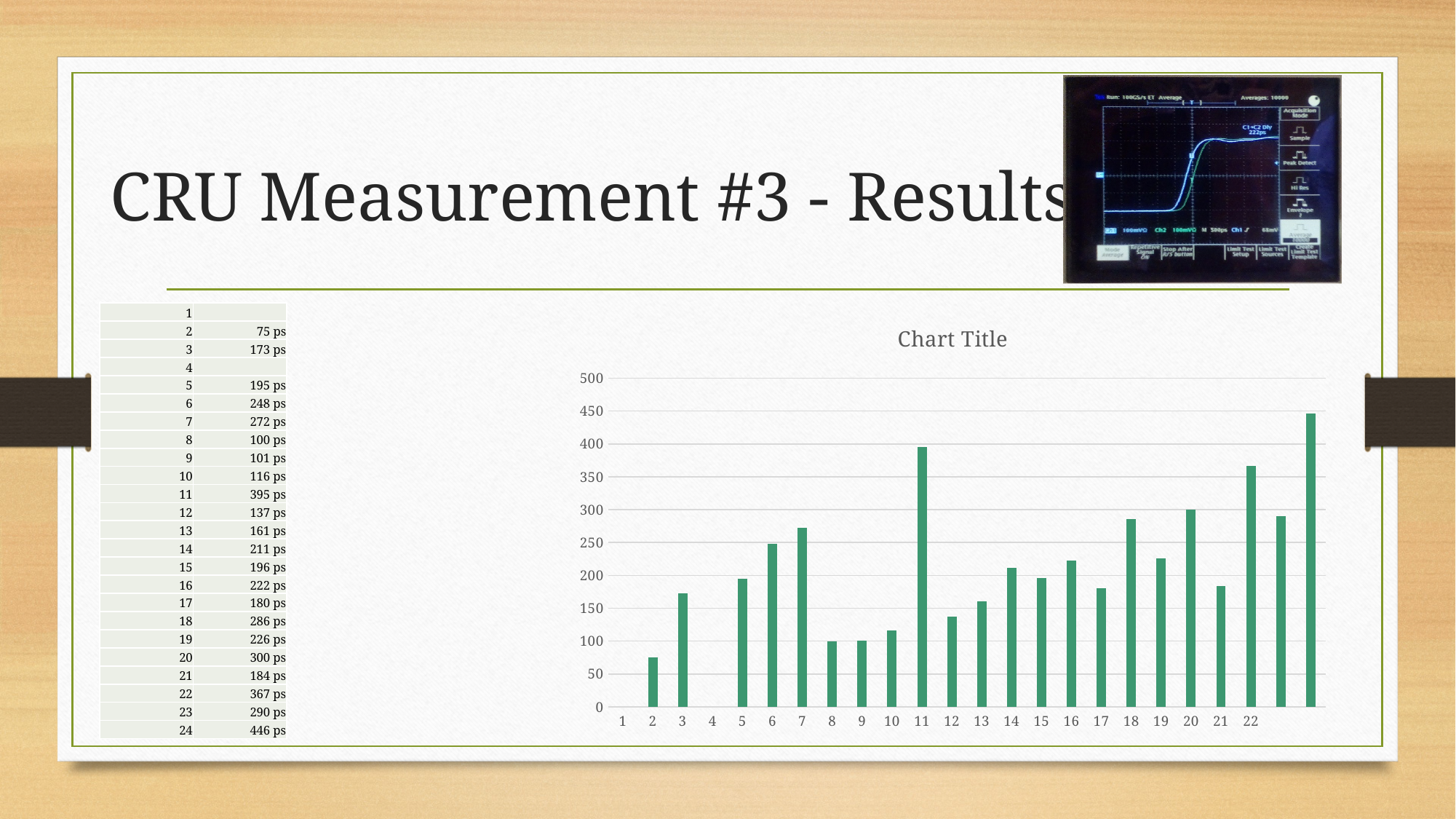
Which is larger, the bar for category 18 or the bar for category 19? 18 Which category has the shortest plotted bar in the chart? 2 Using the table values, what is the difference between category 11 and category 2? 320 ps Among the labelled categories 1 to 22, which has the tallest bar? 11 According to the table on the slide, what is the value for category 16? 222 ps What is the title of the chart? Chart Title Which is larger, the bar for category 7 or the bar for category 6? 7 According to the table on the slide, what is the value for category 11? 395 ps What colour are the bars in the chart? green Is the value for category 8 greater or less than 150? less Is the value for category 11 greater or less than 350? greater What kind of chart is shown on the slide? bar chart